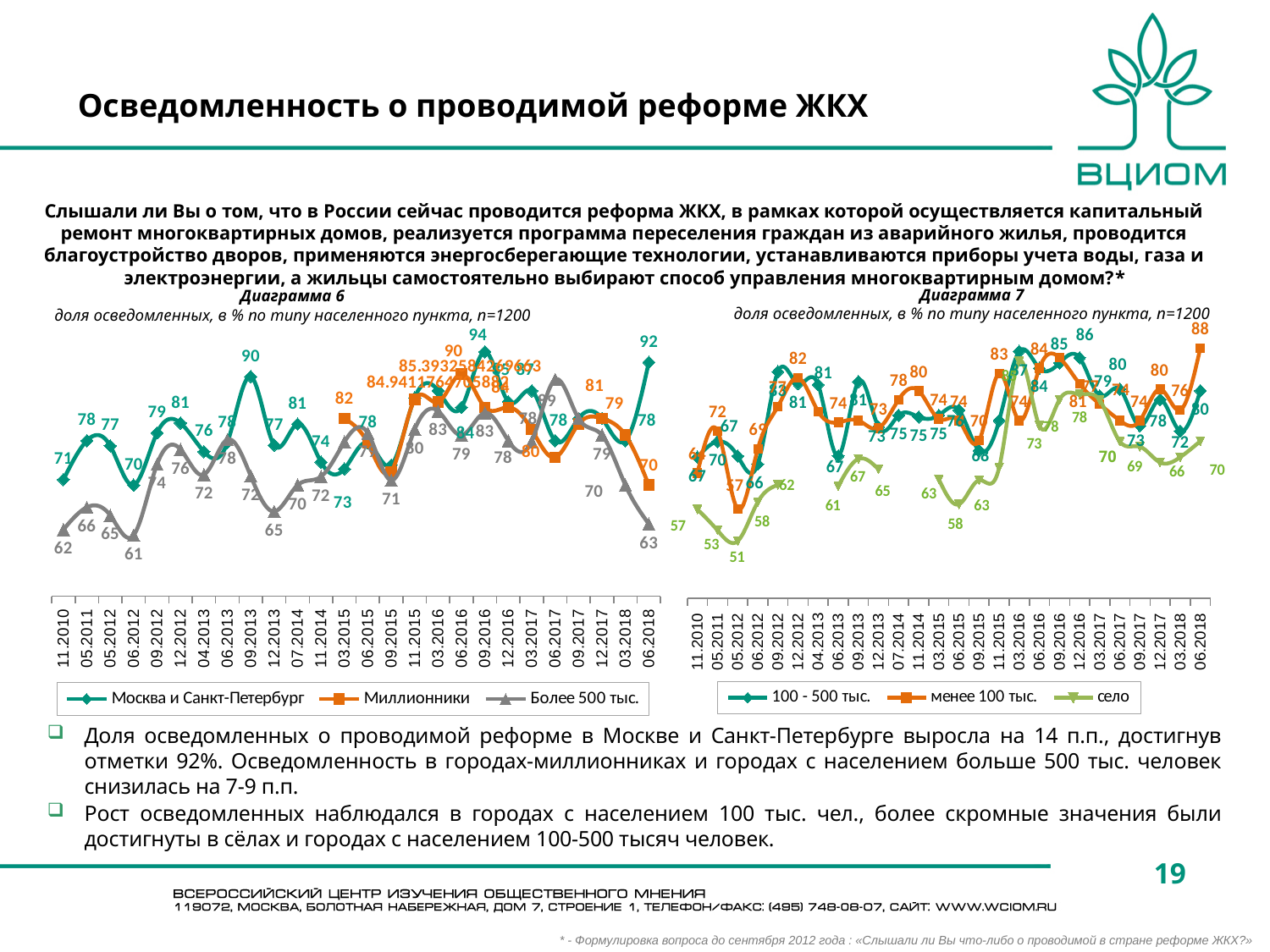
In Диаграмма 6, what is the value for Москва и Санкт-Петербург at 06.2018? 92 In Диаграмма 6, what is the value for Более 500 тыс. at 06.2018? 63 In Диаграмма 7, what is the value for село at 06.2018? 70 How many series does the legend of Диаграмма 7 list? 3 In Диаграмма 6, what is the difference between Москва и Санкт-Петербург and Миллионники at 06.2018? 22 What kind of chart is Диаграмма 6? line chart In Диаграмма 7, what is the value for село at 05.2011? 53 In Диаграмма 7, what is the value for менее 100 тыс. at 06.2018? 88 How many series does the legend of Диаграмма 6 list? 3 In Диаграмма 6, what is the value for Миллионники at 06.2018? 70 In Диаграмма 7, which series has the higher value at 06.2018: менее 100 тыс. or 100 - 500 тыс.? менее 100 тыс. In Диаграмма 6, what is the highest value shown for Москва и Санкт-Петербург? 94